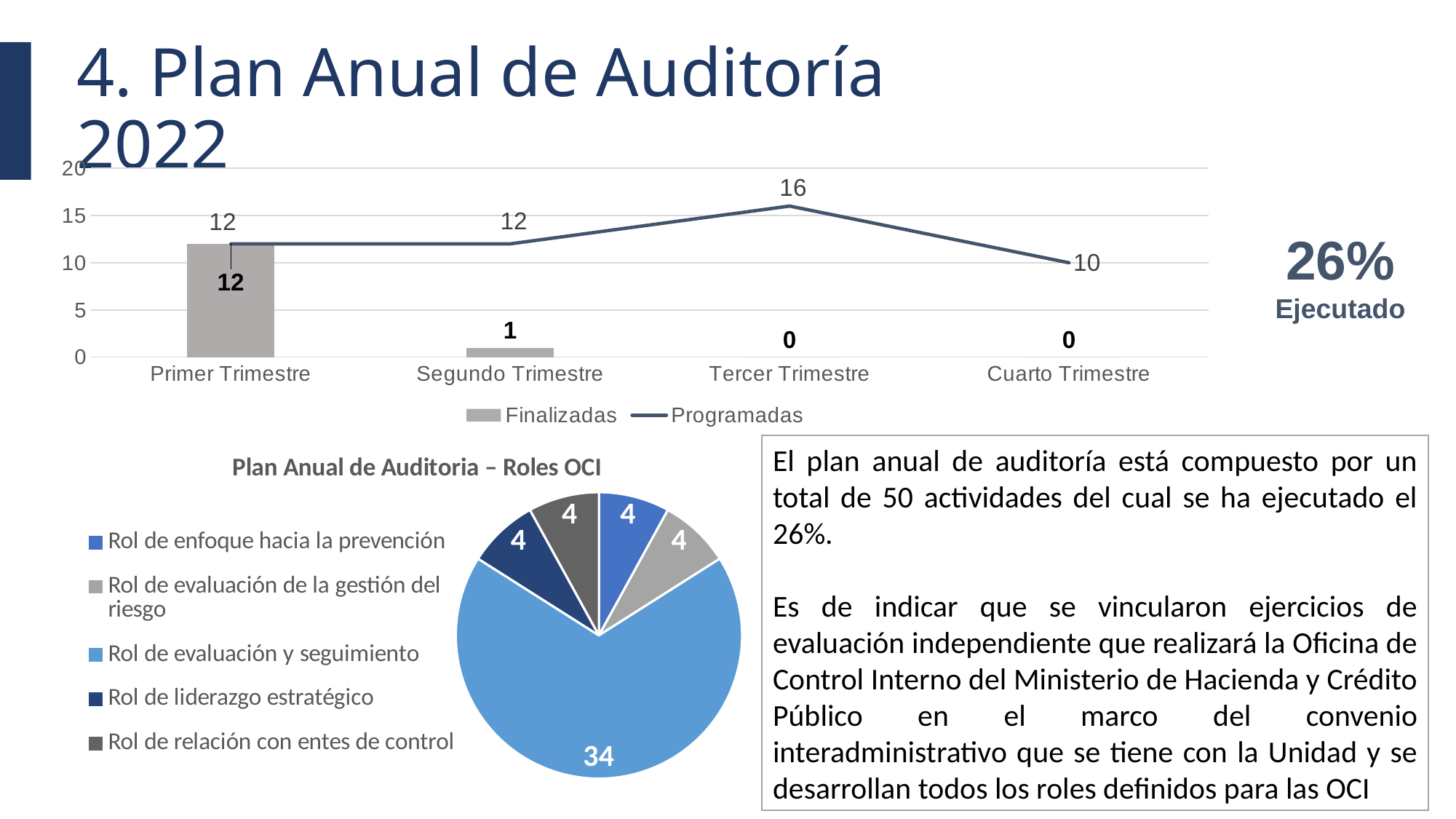
In the 'Plan Anual de Auditoria – Roles OCI' chart, what share of the total does Rol de evaluación y seguimiento represent? 68% In the top chart, which is larger: the Programadas value for Tercer Trimestre or for Cuarto Trimestre? Tercer Trimestre In the 'Plan Anual de Auditoria – Roles OCI' chart, what is the value for Rol de evaluación y seguimiento? 34 In the top chart, what is the Programadas value for Tercer Trimestre? 16 In the top chart, which quarter has the highest Programadas value? Tercer Trimestre In the top chart, what is the difference between Programadas and Finalizadas for Segundo Trimestre? 11 In the top chart, how many quarters are shown on the x axis? 4 In the top chart, what is the Finalizadas value for Segundo Trimestre? 1 What type of chart is 'Plan Anual de Auditoria – Roles OCI'? Pie chart In the top chart, which quarter has the lowest Programadas value? Cuarto Trimestre How many categories does the legend of the 'Plan Anual de Auditoria – Roles OCI' chart list? 5 How many series does the legend of the top chart list? 2